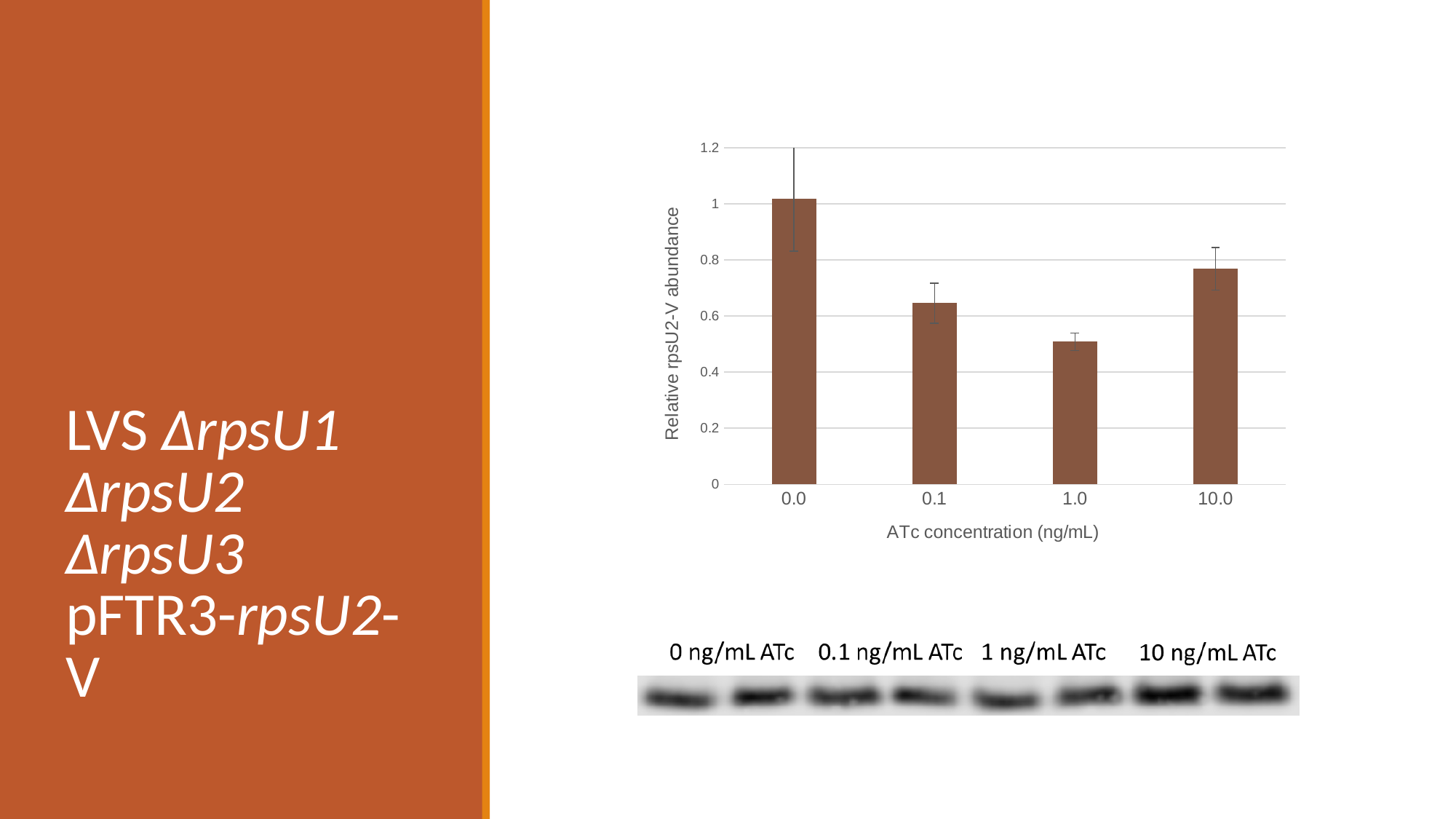
Which ATc concentration has the lowest relative rpsU2-V abundance? 1.0 Is the value for 0.0 ng/mL ATc greater or less than 0.8? greater Is the value for 10.0 ng/mL ATc greater or less than 0.6? greater What is the label of the x axis of the bar chart? ATc concentration (ng/mL) Which has a larger relative rpsU2-V abundance, 0.1 ng/mL ATc or 10.0 ng/mL ATc? 10.0 How many ATc concentration categories are plotted in the bar chart? 4 Which has a larger relative rpsU2-V abundance, 0.0 ng/mL ATc or 1.0 ng/mL ATc? 0.0 Is the value for 0.1 ng/mL ATc greater or less than 0.8? less What is the label of the y axis of the bar chart? Relative rpsU2-V abundance Which ATc concentration has the highest relative rpsU2-V abundance? 0.0 What kind of chart is shown on the slide? bar chart